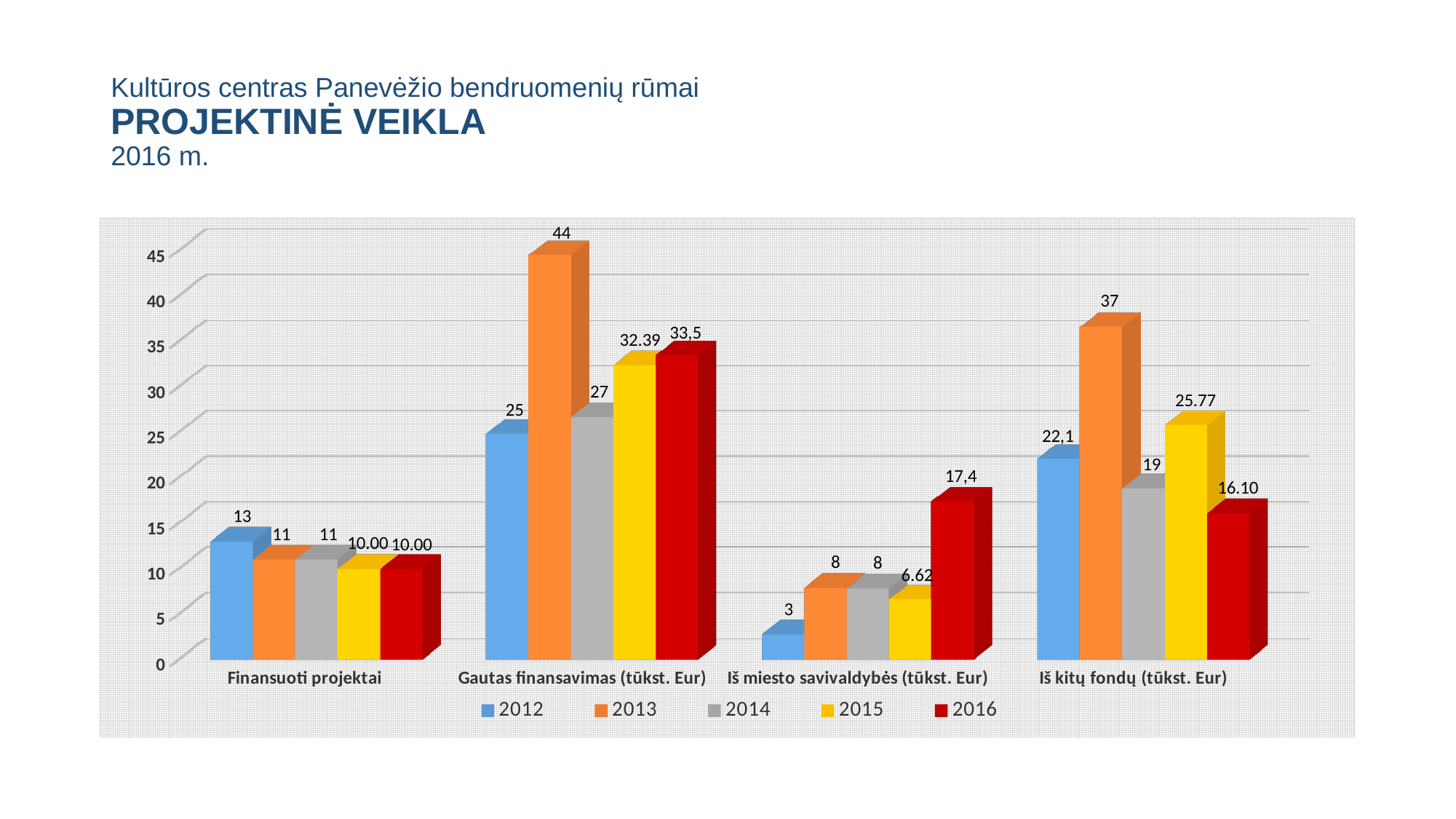
What is the value for 2015 in the "Iš kitų fondų (tūkst. Eur)" category? 25.77 How many categories are shown on the x axis of the chart? 4 Which colour represents the 2016 series in the legend? Red What is the value for 2012 in the "Finansuoti projektai" category? 13 Which year has the lowest value in the "Iš miesto savivaldybės (tūkst. Eur)" category? 2012 In the "Iš kitų fondų (tūkst. Eur)" category, which is larger: the value for 2012 or the value for 2014? 2012 What is the value for 2013 in the "Gautas finansavimas (tūkst. Eur)" category? 44 What is the difference between the 2013 and 2012 values in the "Gautas finansavimas (tūkst. Eur)" category? 19 Which year has the highest value in the "Iš kitų fondų (tūkst. Eur)" category? 2013 What is the value for 2016 in the "Iš miesto savivaldybės (tūkst. Eur)" category? 17,4 What kind of chart is shown on the slide? Bar chart How many series does the legend list? 5